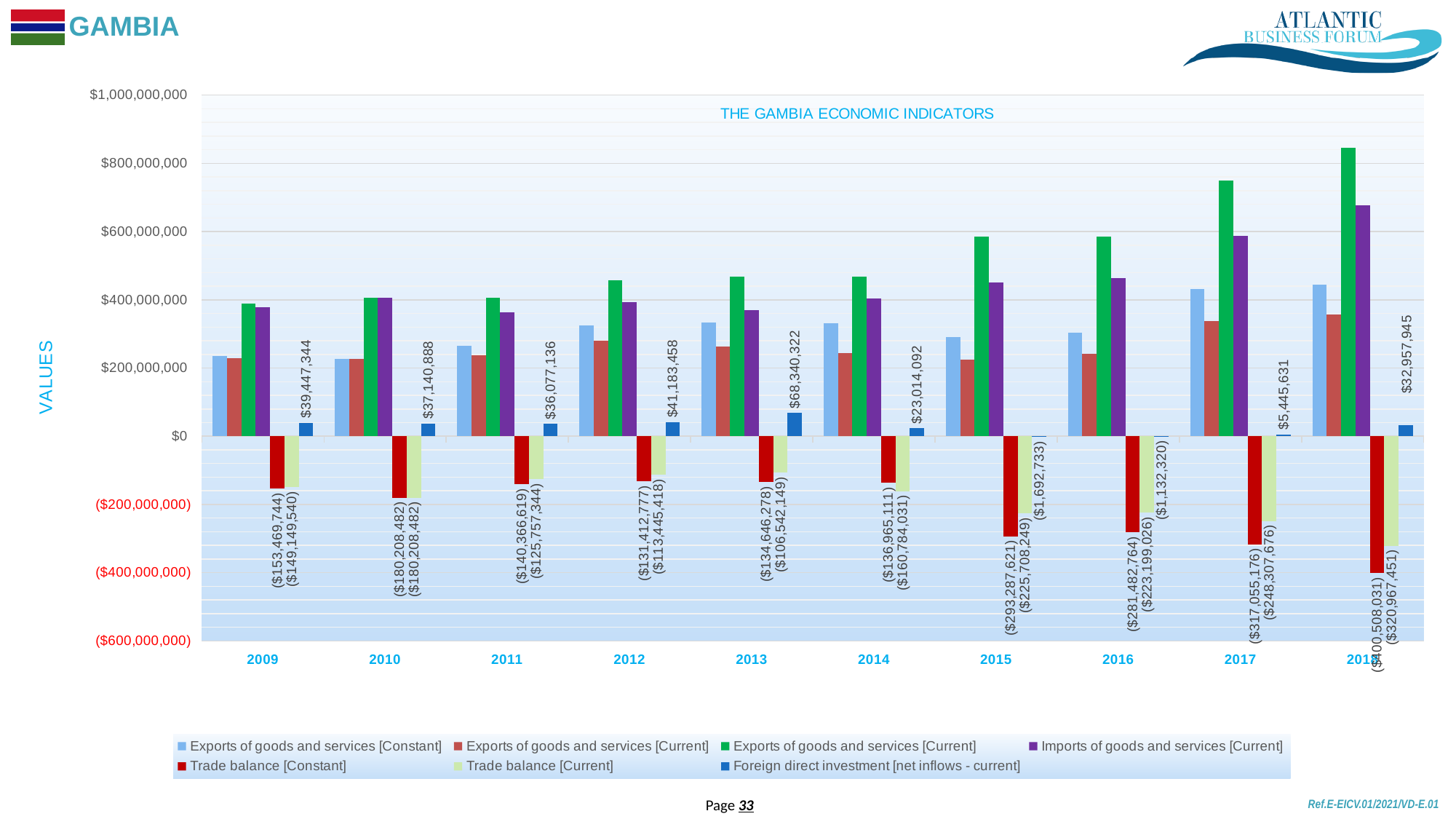
What is the title of the chart? THE GAMBIA ECONOMIC INDICATORS What is the value of Foreign direct investment [net inflows - current] for 2013? $68,340,322 Which is larger, Imports of goods and services [Current] in 2018 or in 2009? 2018 What is the value of Trade balance [Constant] for 2018? ($400,508,031) What is the difference between Foreign direct investment [net inflows - current] in 2009 and in 2010? $2,306,456 How many series does the legend list? 7 What is the value of Trade balance [Current] for 2010? ($180,208,482) What kind of chart is this? bar chart In which year is Foreign direct investment [net inflows - current] highest? 2013 Is the value of the green Exports of goods and services [Current] bar for 2018 greater or less than $800,000,000? greater In which year is Foreign direct investment [net inflows - current] lowest? 2015 How many years are shown on the x axis? 10